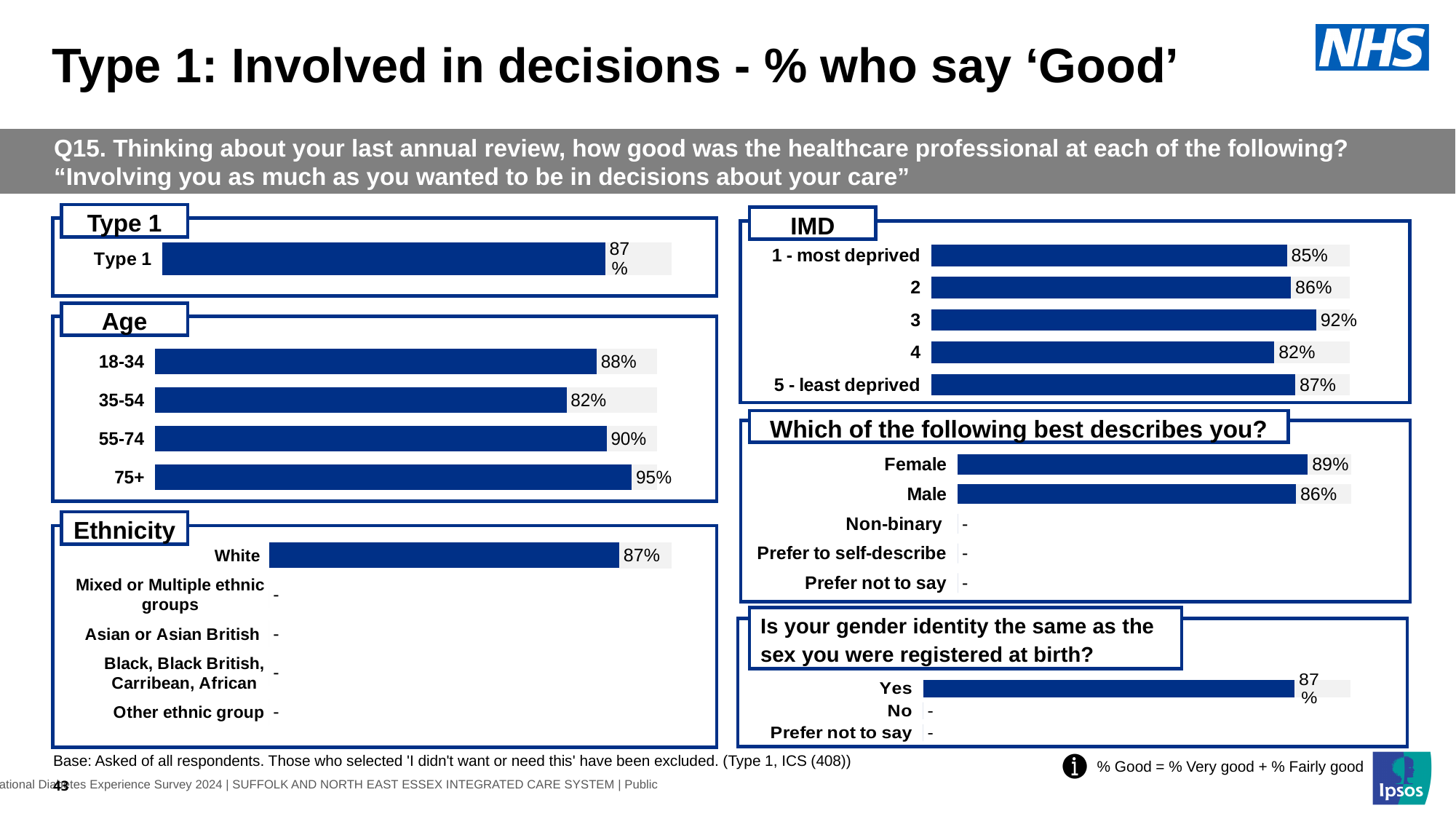
In the 'Is your gender identity the same as the sex you were registered at birth?' chart, what is the value for Yes? 87% In the Age chart, how many age groups are shown? 4 What kind of chart is the IMD chart? Bar chart In the Age chart, which age group has the lowest value? 35-54 In the Age chart, what is the value for the 75+ group? 95% In the IMD chart, which category has the highest value? 3 In the Age chart, what is the difference between the 75+ value and the 35-54 value? 13 percentage points In the IMD chart, which category has the lowest value? 4 In the IMD chart, what is the value for '1 - most deprived'? 85% In the IMD chart, what is the difference between category 3 and '5 - least deprived'? 5 percentage points In the 'Which of the following best describes you?' chart, which is larger, Female or Male? Female In the Ethnicity chart, what is the value for White? 87%